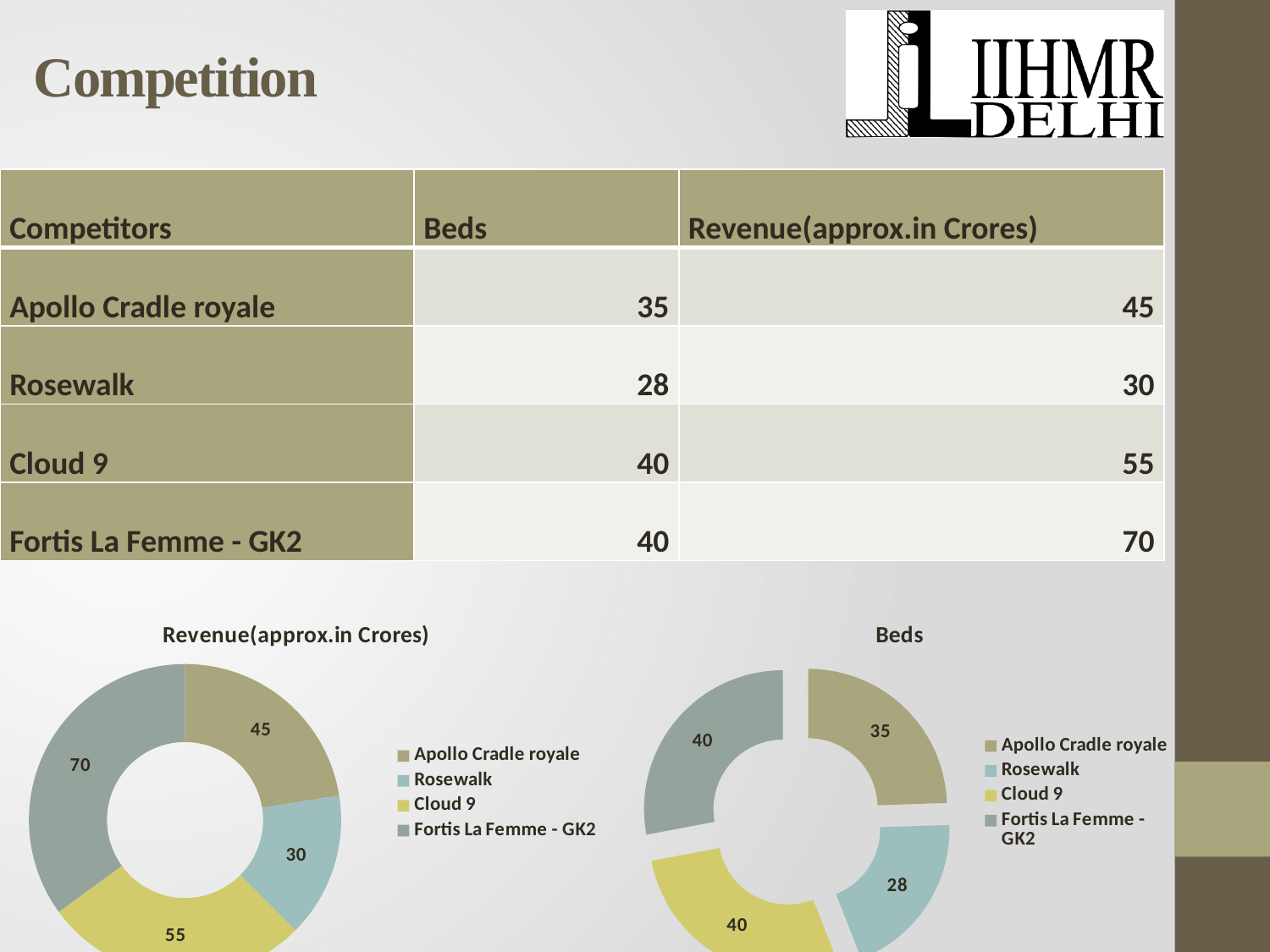
In the Beds chart, what share of the total do the 40 beds of Cloud 9 represent? 28% In the Beds chart, which is larger, the value for Apollo Cradle royale or the value for Cloud 9? Cloud 9 In the Beds chart, what is the value for Apollo Cradle royale? 35 In the Revenue(approx.in Crores) chart, which competitor has the highest value? Fortis La Femme - GK2 In the Beds chart, what is the value for Rosewalk? 28 In the Revenue(approx.in Crores) chart, what is the difference between the values for Fortis La Femme - GK2 and Apollo Cradle royale? 25 In the Beds chart, which competitor has the lowest value? Rosewalk What kind of chart is the Revenue(approx.in Crores) chart? Doughnut chart In the Revenue(approx.in Crores) chart, what is the value for Rosewalk? 30 In the Revenue(approx.in Crores) chart, what is the value for Fortis La Femme - GK2? 70 In the Revenue(approx.in Crores) chart, which competitor has the lowest value? Rosewalk How many competitors are shown in the Beds chart? 4